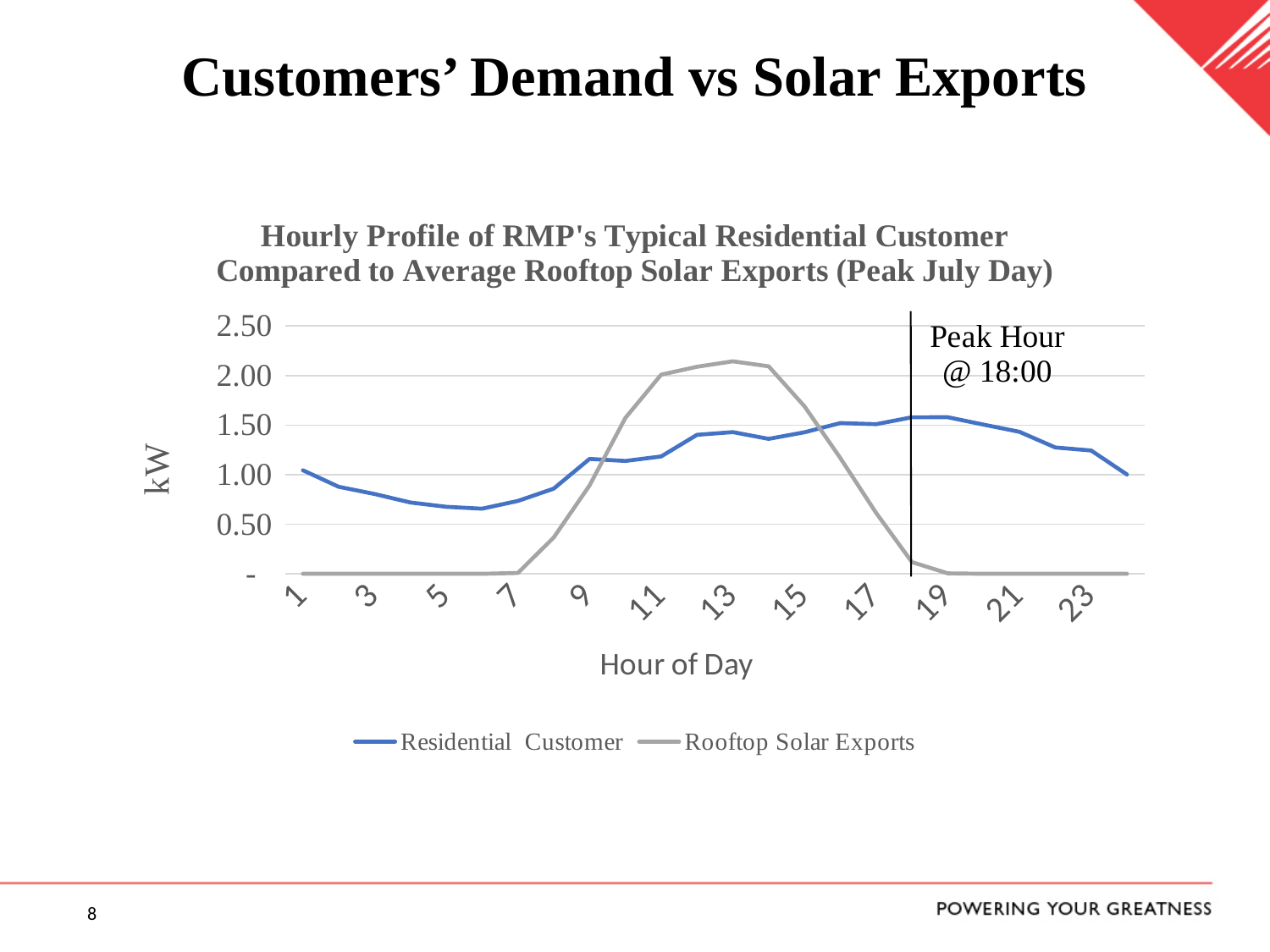
Is the Residential Customer value at hour 6 greater or less than 1.00? less Is the Rooftop Solar Exports value at hour 8 greater or less than 0.50? less Does the Rooftop Solar Exports line rise or fall between hour 8 and hour 13? rise At hour 13, which series has the higher value, Residential Customer or Rooftop Solar Exports? Rooftop Solar Exports At hour 18, which series has the higher value, Residential Customer or Rooftop Solar Exports? Residential Customer What are the two series named in the legend? Residential Customer and Rooftop Solar Exports How many series does the legend list? 2 At which hour does the Residential Customer line reach its peak, according to the annotation? 18:00 What is the label on the vertical axis? kW Does the Residential Customer line rise or fall between hour 1 and hour 6? fall Is the Rooftop Solar Exports value at hour 13 greater or less than 2.00? greater What kind of chart is shown on the slide? Line chart